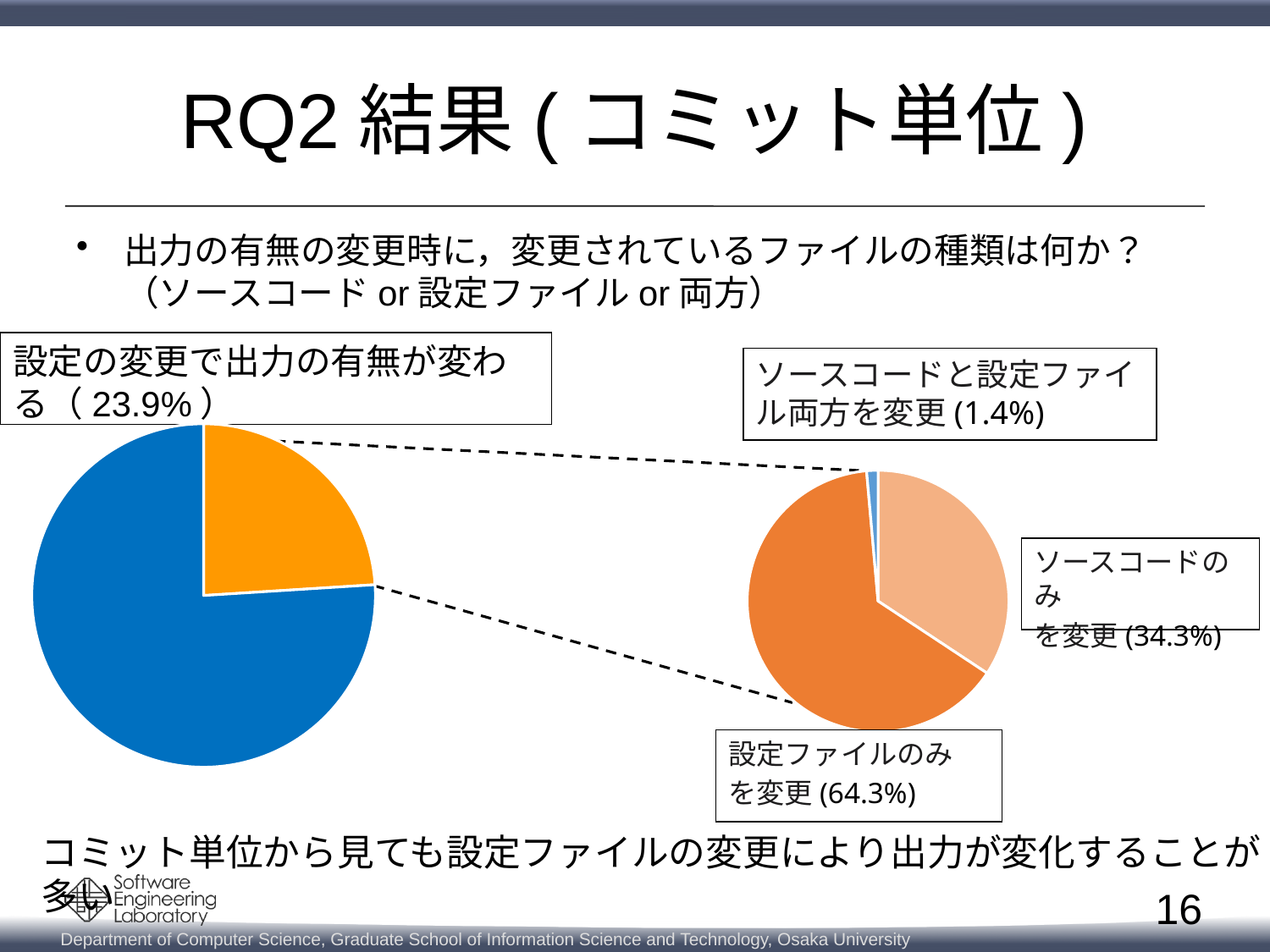
On the left pie chart, what percentage is shown for the slice labelled 設定の変更で出力の有無が変わる? 23.9% On the right pie chart, which is larger: the share for ソースコードのみを変更 or the share for ソースコードと設定ファイル両方を変更? ソースコードのみを変更 On the right pie chart, what percentage of commits changed only the configuration file (設定ファイルのみを変更)? 64.3% On the right pie chart, what percentage of commits changed only the source code (ソースコードのみを変更)? 34.3% How many pie charts are shown on the slide? 2 On the right pie chart, what is the difference in percentage points between 設定ファイルのみを変更 and ソースコードのみを変更? 30.0 On the right pie chart, what percentage of commits changed both source code and configuration file (ソースコードと設定ファイル両方を変更)? 1.4% How many slices does the right pie chart have? 3 What type of chart is used on the left side of the slide? pie chart On the left pie chart, which slice is larger: the blue slice or the orange slice? the blue slice On the right pie chart, which category has the smallest share? ソースコードと設定ファイル両方を変更 On the right pie chart, which category has the largest share? 設定ファイルのみを変更